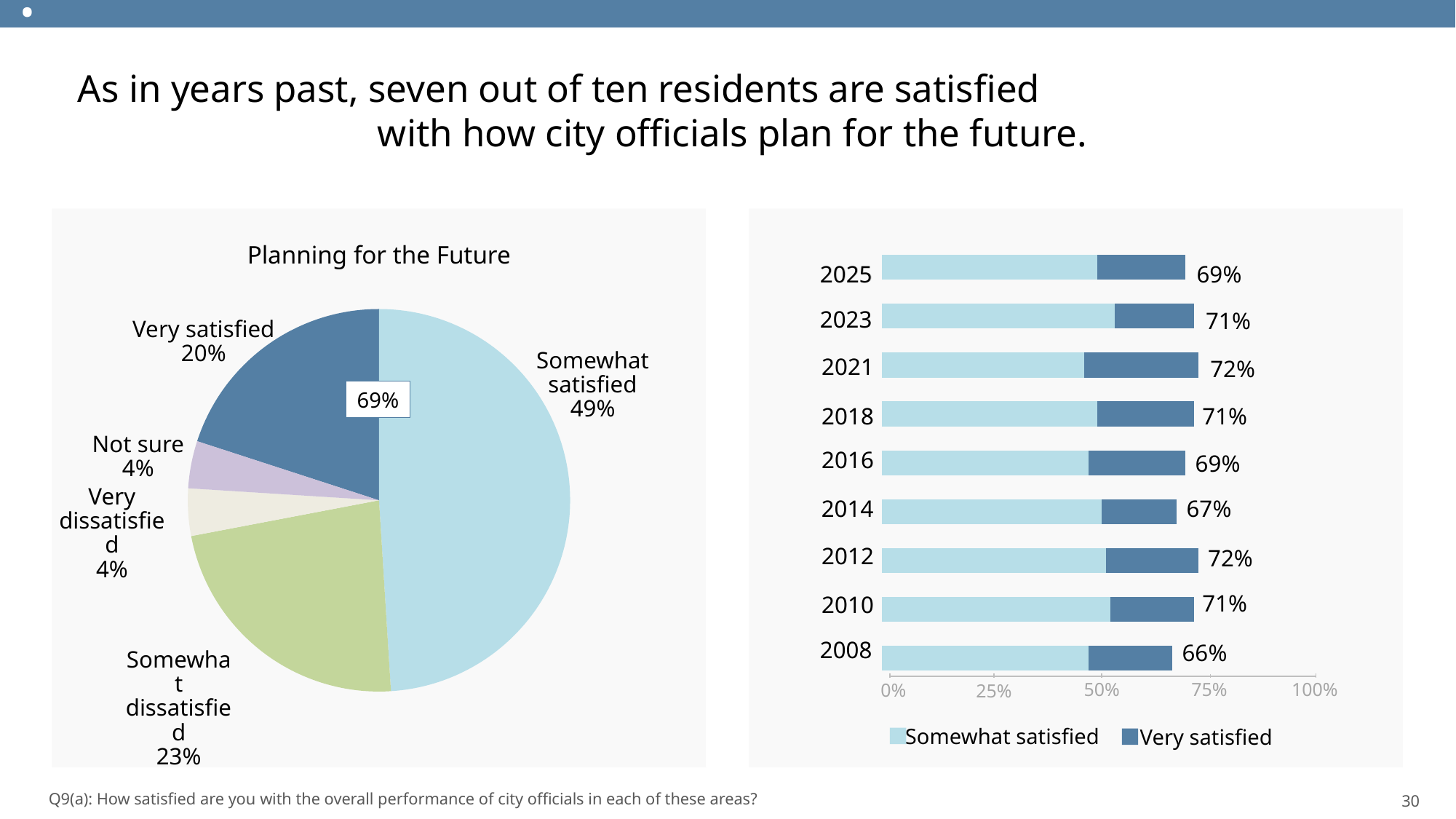
In the pie chart titled "Planning for the Future", what combined percentage is shown in the box in the centre of the pie? 69% In the pie chart titled "Planning for the Future", how many percentage points larger is the somewhat satisfied slice than the somewhat dissatisfied slice? 26 percentage points In the bar chart on the right, what is the total satisfied percentage for 2008? 66% In the bar chart on the right, which year has the lowest total satisfied percentage? 2008 In the pie chart titled "Planning for the Future", what percentage are very satisfied? 20% In the pie chart titled "Planning for the Future", how many slices does the pie have? 5 In the pie chart titled "Planning for the Future", what share of residents are somewhat satisfied? 49% In the bar chart on the right, how many series does the legend list? 2 In the bar chart on the right, what is the difference in percentage points between the totals for 2021 and 2008? 6 percentage points In the bar chart on the right, what is the total satisfied percentage for 2021? 72% In the pie chart titled "Planning for the Future", which category has the largest slice? Somewhat satisfied In the bar chart on the right, which year has a higher total satisfied percentage, 2023 or 2014? 2023